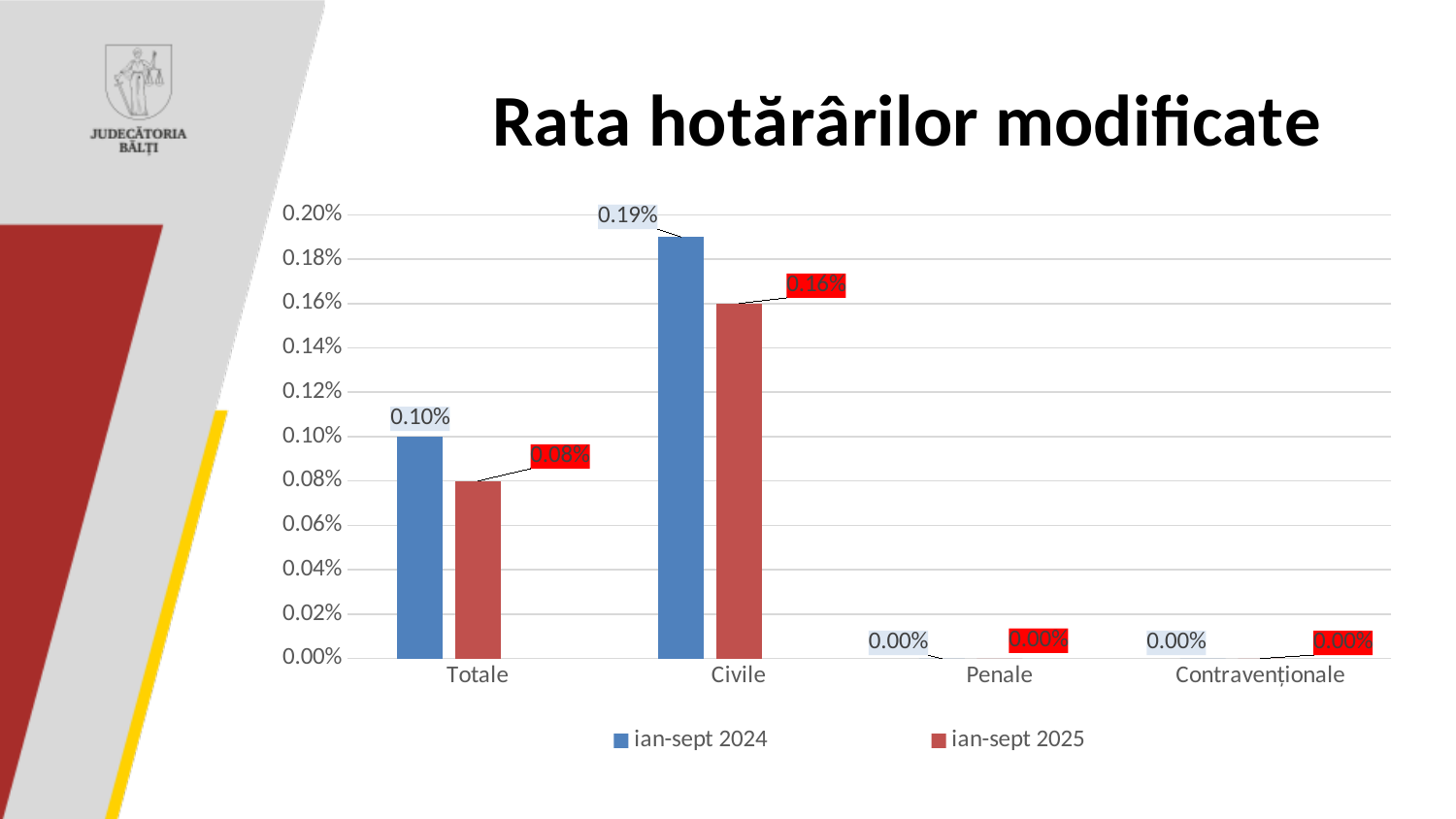
How many categories are shown on the x axis? 4 What kind of chart is shown on the slide? Bar chart What is the value for Totale in the ian-sept 2025 series? 0.08% How many series does the legend list? 2 What is the difference between the ian-sept 2024 and ian-sept 2025 values for Civile? 0.03% What is the value for Civile in the ian-sept 2024 series? 0.19% What is the value for Civile in the ian-sept 2025 series? 0.16% What is the title of the chart? Rata hotărârilor modificate Which is larger for Totale: the ian-sept 2024 value or the ian-sept 2025 value? ian-sept 2024 Which category has the highest value in the ian-sept 2024 series? Civile What is the difference between the ian-sept 2024 and ian-sept 2025 values for Totale? 0.02% What is the value for Penale in the ian-sept 2024 series? 0.00%